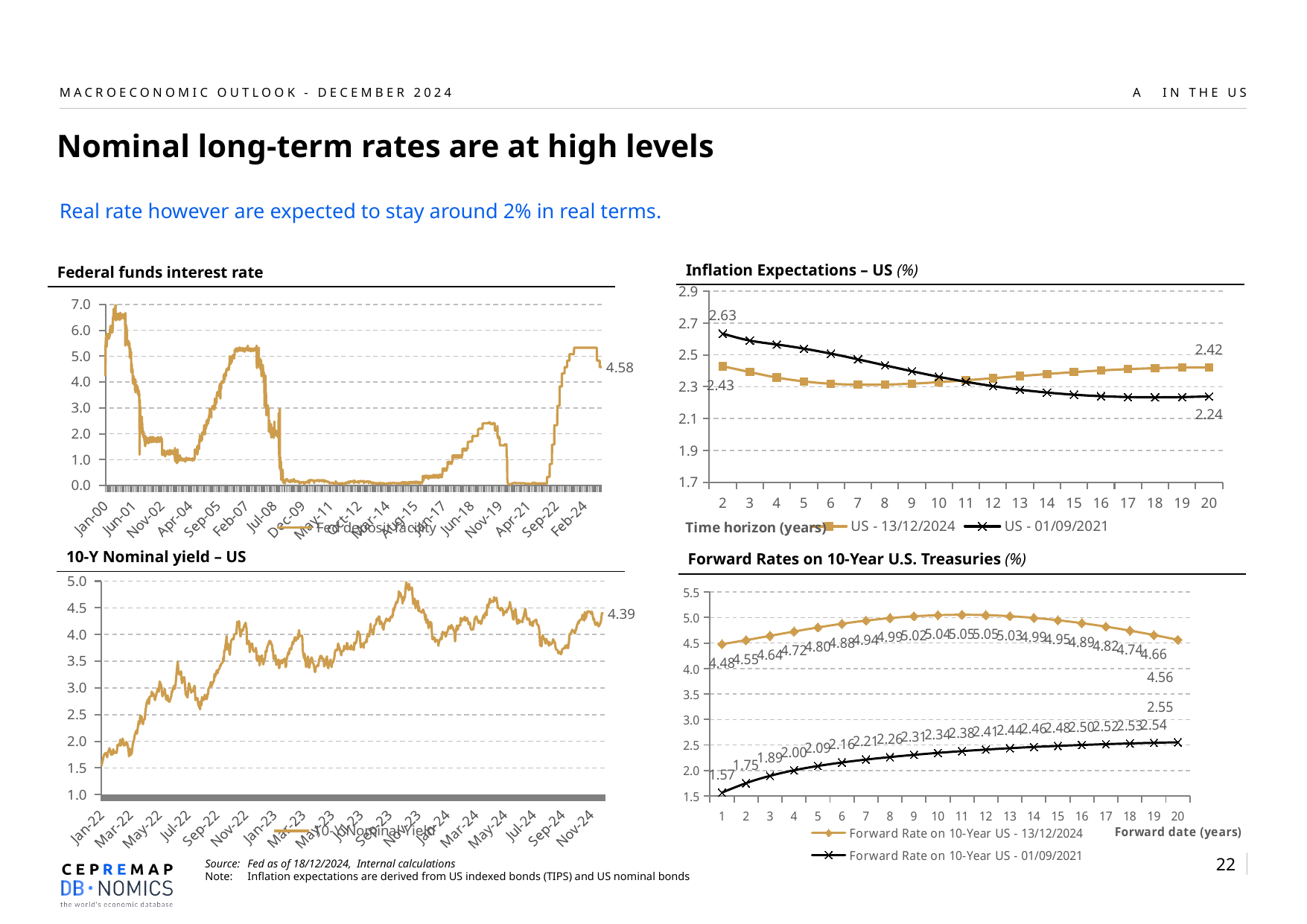
On the Forward Rates on 10-Year U.S. Treasuries chart, what is the forward rate for 01/09/2021 at a forward date of 20 years? 2.55 On the Inflation Expectations – US chart, which series is higher at the 20-year horizon? US - 13/12/2024 On the Forward Rates on 10-Year U.S. Treasuries chart, what is the forward rate for 13/12/2024 at a forward date of 1 year? 4.48 On the Forward Rates on 10-Year U.S. Treasuries chart, what is the highest value reached by the 13/12/2024 series? 5.05 On the Inflation Expectations – US chart, what is the value of the US - 01/09/2021 series at a 2-year horizon? 2.63 On the Inflation Expectations – US chart, what is the difference between the two series at the 2-year horizon (2.63 vs 2.43)? 0.20 On the Federal funds interest rate chart, what is the latest value labelled at the end of the line? 4.58 On the Forward Rates on 10-Year U.S. Treasuries chart, does the 01/09/2021 series rise or fall as the forward date increases? rises On the 10-Y Nominal yield – US chart, what is the latest value labelled at the end of the line? 4.39 On the Inflation Expectations – US chart, what is the value of the US - 13/12/2024 series at a 20-year horizon? 2.42 What kind of chart is the Federal funds interest rate chart? line chart How many series does the legend of the Inflation Expectations – US chart list? 2